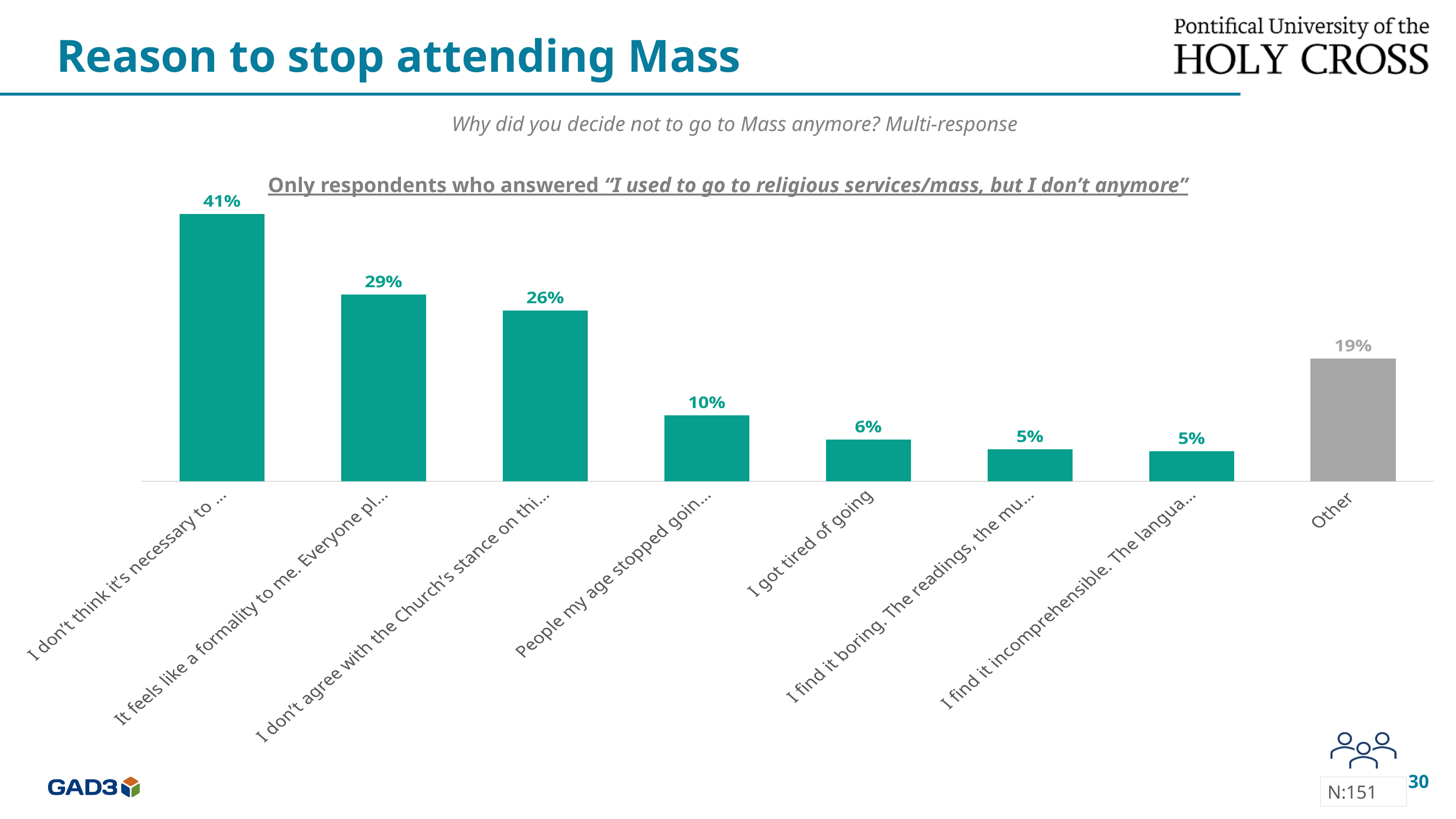
Which is larger, the value for "Other" or the value for "I got tired of going"? Other What is the difference between the highest bar (41%) and the second-highest bar (29%)? 12% What is the difference between the "Other" bar and the "I got tired of going" bar? 13% What colour is the "Other" bar? Grey What is the value for the "Other" bar? 19% How many bars have a value of 5%? 2 What kind of chart is shown on the slide? Bar chart What is the highest value shown on the chart? 41% How many bars are shown on the chart? 8 What is the value for the bar whose label begins "People my age stopped goin..."? 10% What is the lowest value shown on the chart? 5% What is the value for the bar labelled "I got tired of going"? 6%